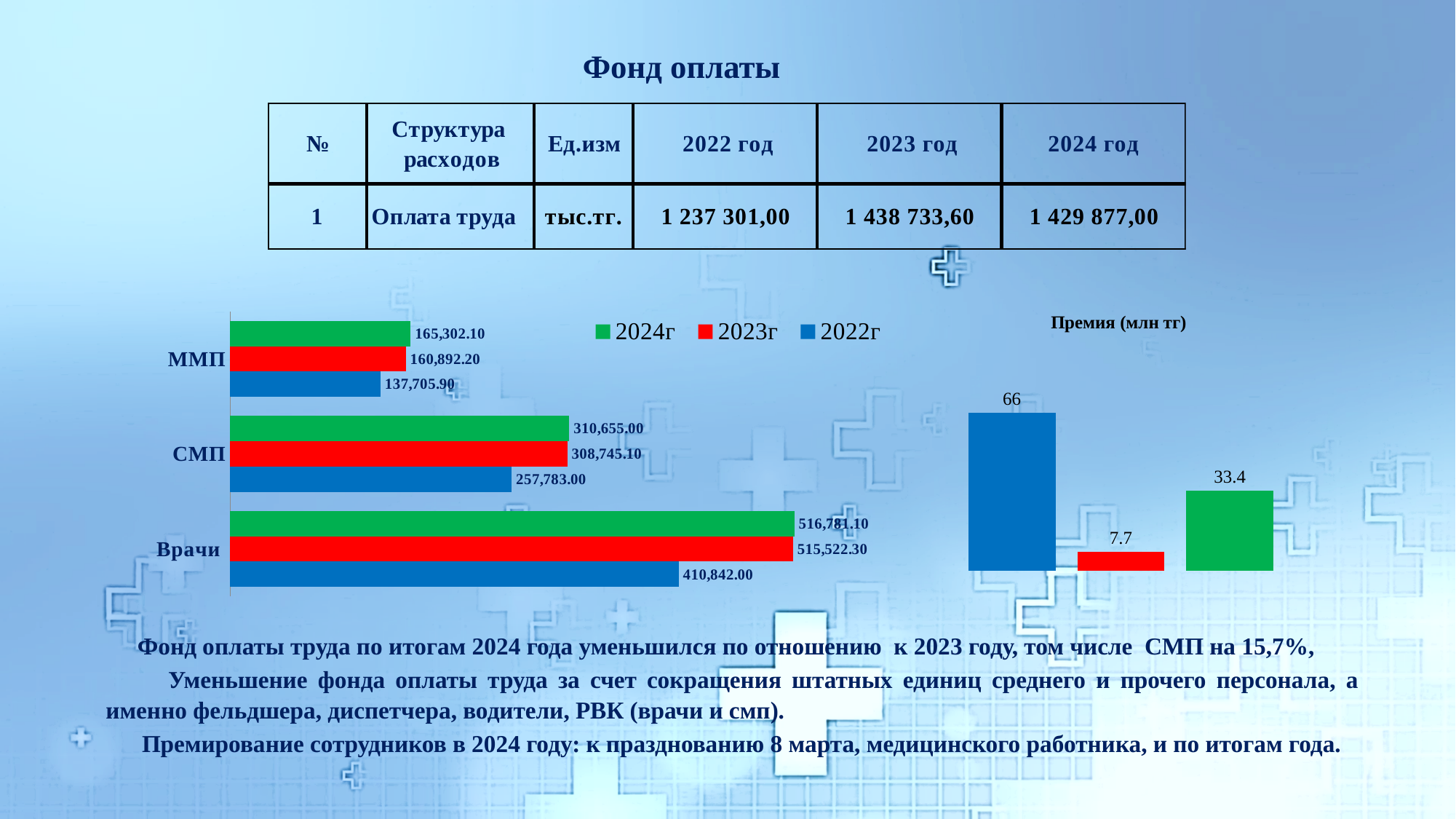
In the left bar chart, what is the difference between the 2024г and 2022г values for Врачи? 105,939.10 How many categories are shown in the left bar chart? 3 In the left bar chart, which category has the lowest 2022г value? ММП In the Премия (млн тг) chart, what is the value of the red bar? 7.7 In the left bar chart, what is the 2024г value for Врачи? 516,781.10 How many series does the legend of the left bar chart list? 3 What kind of chart is the left chart? Bar chart In the left bar chart, which category has the highest 2024г value? Врачи In the Премия (млн тг) chart, what is the value of the tallest (blue) bar? 66 In the left bar chart, what is the 2023г value for ММП? 160,892.20 In the left bar chart, what is the 2022г value for СМП? 257,783.00 In the left bar chart, which is larger for СМП: the 2023г value or the 2022г value? 2023г